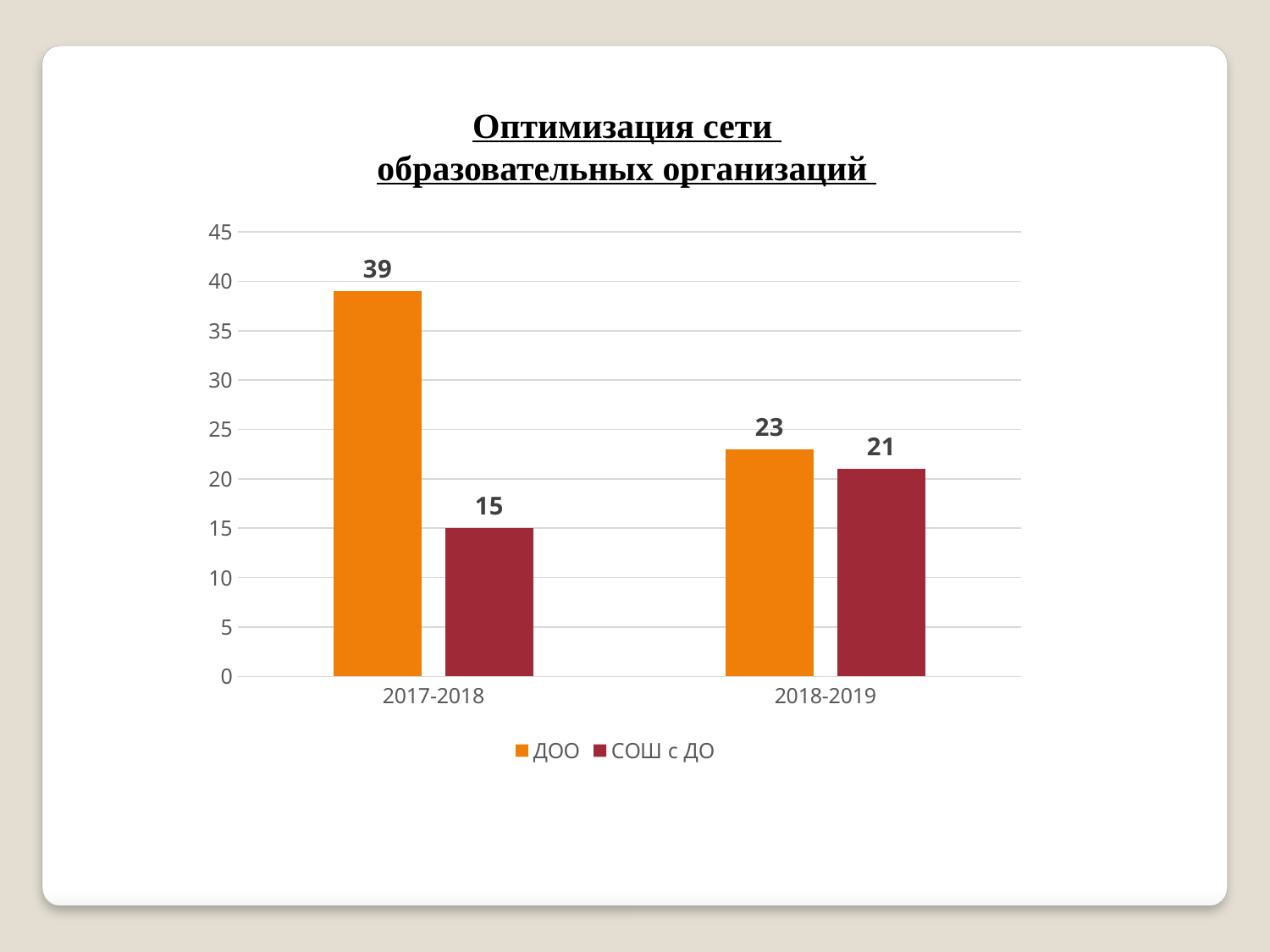
What is the value for ДОО in 2017-2018? 39 What is the difference between ДОО and СОШ с ДО in 2017-2018? 24 What kind of chart is shown on the slide? bar chart In which period is the value for СОШ с ДО lowest? 2017-2018 What is the value for СОШ с ДО in 2018-2019? 21 Which is larger in 2018-2019, ДОО or СОШ с ДО? ДОО What is the value for ДОО in 2018-2019? 23 How many series does the legend list? 2 In which period is the value for ДОО highest? 2017-2018 What is the value for СОШ с ДО in 2017-2018? 15 By how much did the value for ДОО fall from 2017-2018 to 2018-2019? 16 Does the value for ДОО rise or fall from 2017-2018 to 2018-2019? fall